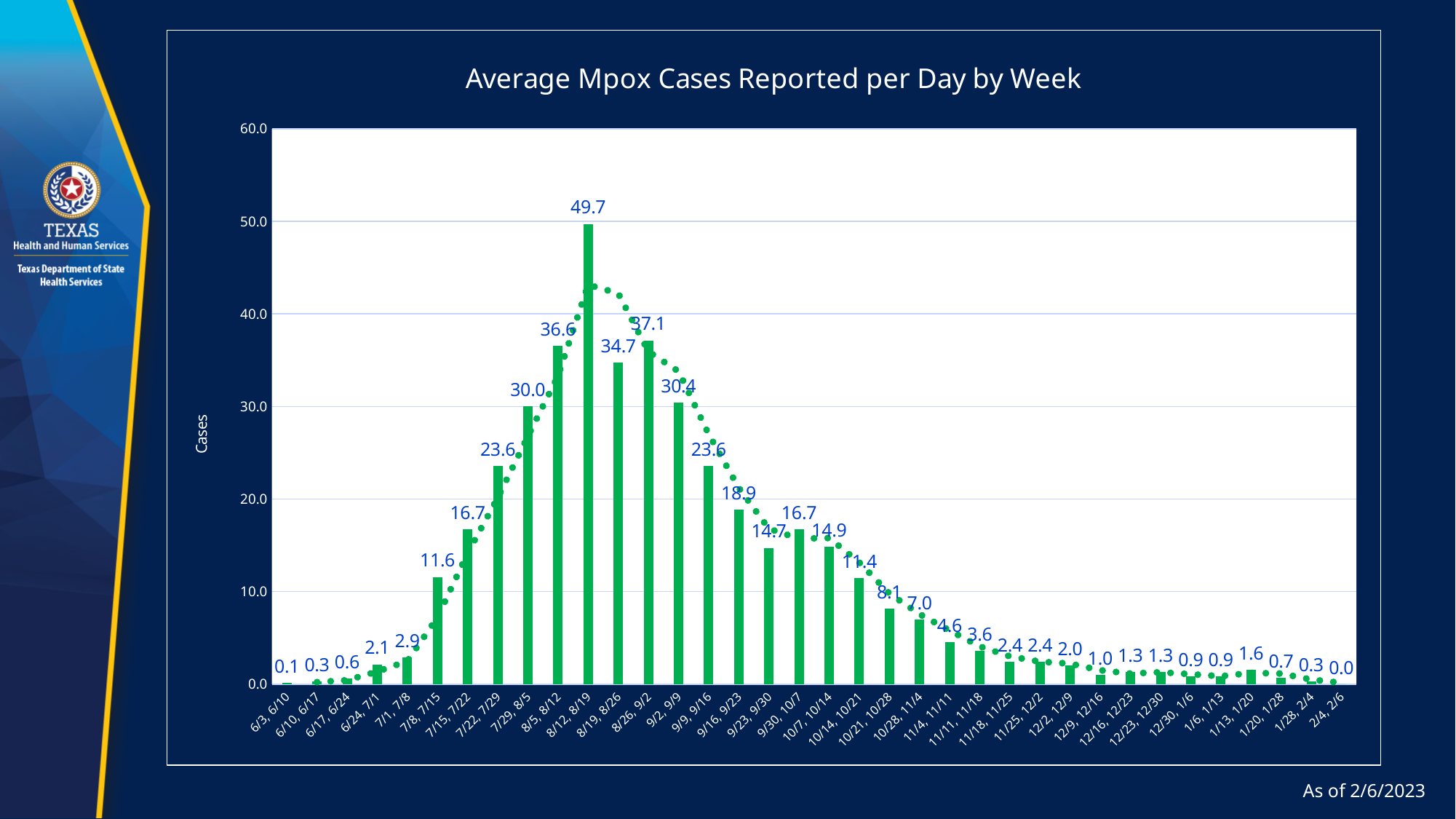
What is the average number of mpox cases per day for the week 8/12, 8/19? 49.7 How many weeks are shown on the x axis of the chart? 36 Which week has a higher average of cases per day: 8/19, 8/26 or 8/26, 9/2? 8/26, 9/2 What is the difference between the average cases per day for the week 8/12, 8/19 and the week 8/19, 8/26? 15.0 What is the average number of mpox cases per day for the week 9/30, 10/7? 16.7 Is the value for the week 7/29, 8/5 greater or less than 20.0? greater What is the average number of mpox cases per day for the week 11/4, 11/11? 4.6 Do the average cases per day generally rise or fall from the week 8/26, 9/2 to the week 2/4, 2/6? Fall What is the title of the chart? Average Mpox Cases Reported per Day by Week Which week has the lowest average number of mpox cases per day? 2/4, 2/6 What type of chart is used to show the average mpox cases per day by week? Bar chart Which week has the highest average number of mpox cases per day? 8/12, 8/19